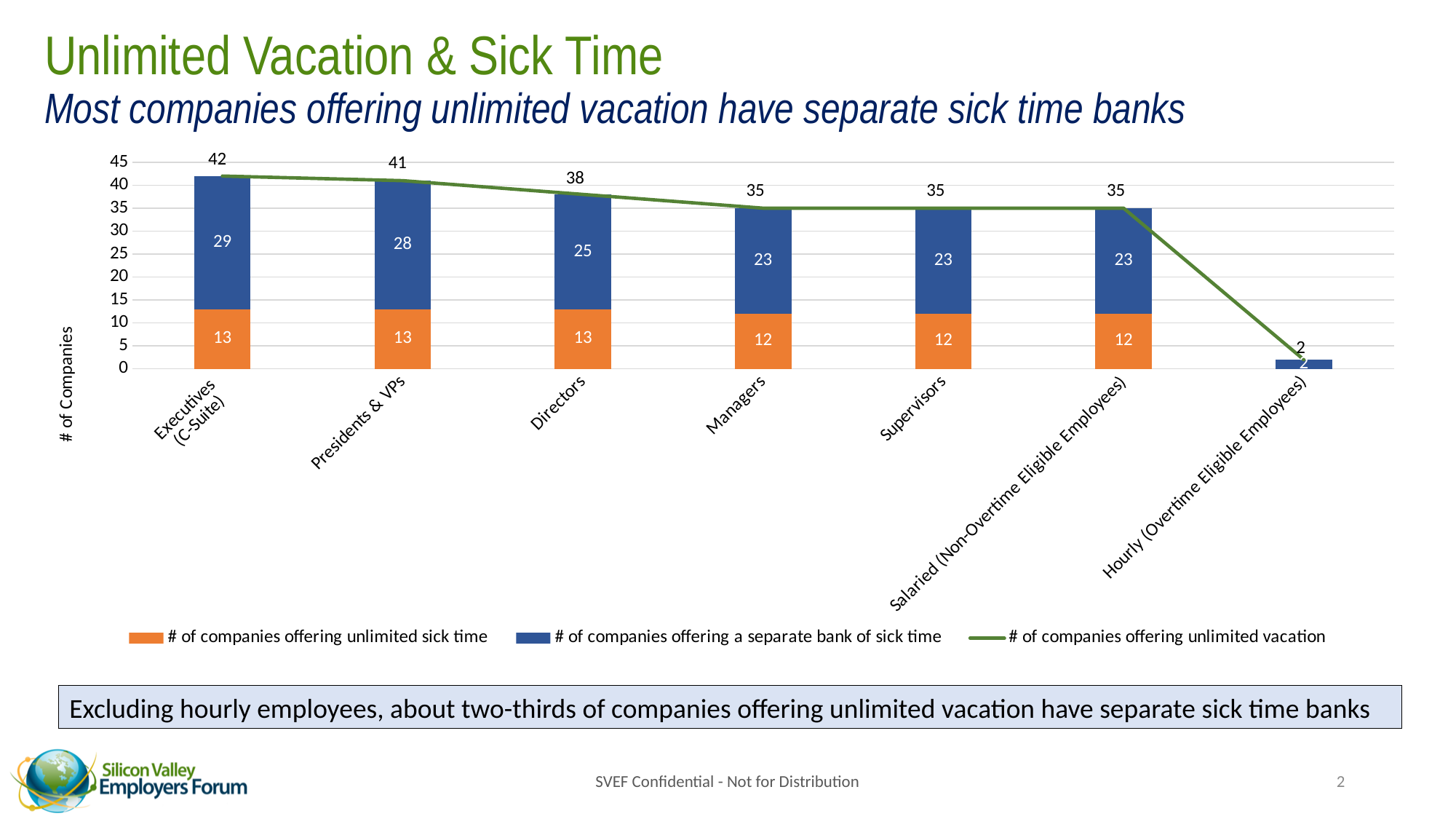
How many employee categories are shown on the x axis? 7 How many series does the legend list? 3 How many companies offer unlimited sick time for Directors? 13 Which category has the highest number of companies offering unlimited vacation? Executives (C-Suite) Does the number of companies offering unlimited vacation rise or fall from Executives (C-Suite) to Hourly (Overtime Eligible Employees)? Fall Which category has the lowest number of companies offering unlimited vacation? Hourly (Overtime Eligible Employees) What is the difference between the number of companies offering unlimited vacation for Executives (C-Suite) and for Directors? 4 What is the total height of the stacked bar for Managers? 35 Which is larger: the number of companies offering a separate bank of sick time for Presidents & VPs or for Managers? Presidents & VPs How many companies offer unlimited vacation for Presidents & VPs? 41 How many companies offer a separate bank of sick time for Executives (C-Suite)? 29 What kind of chart is shown on the slide? Stacked bar chart with a line